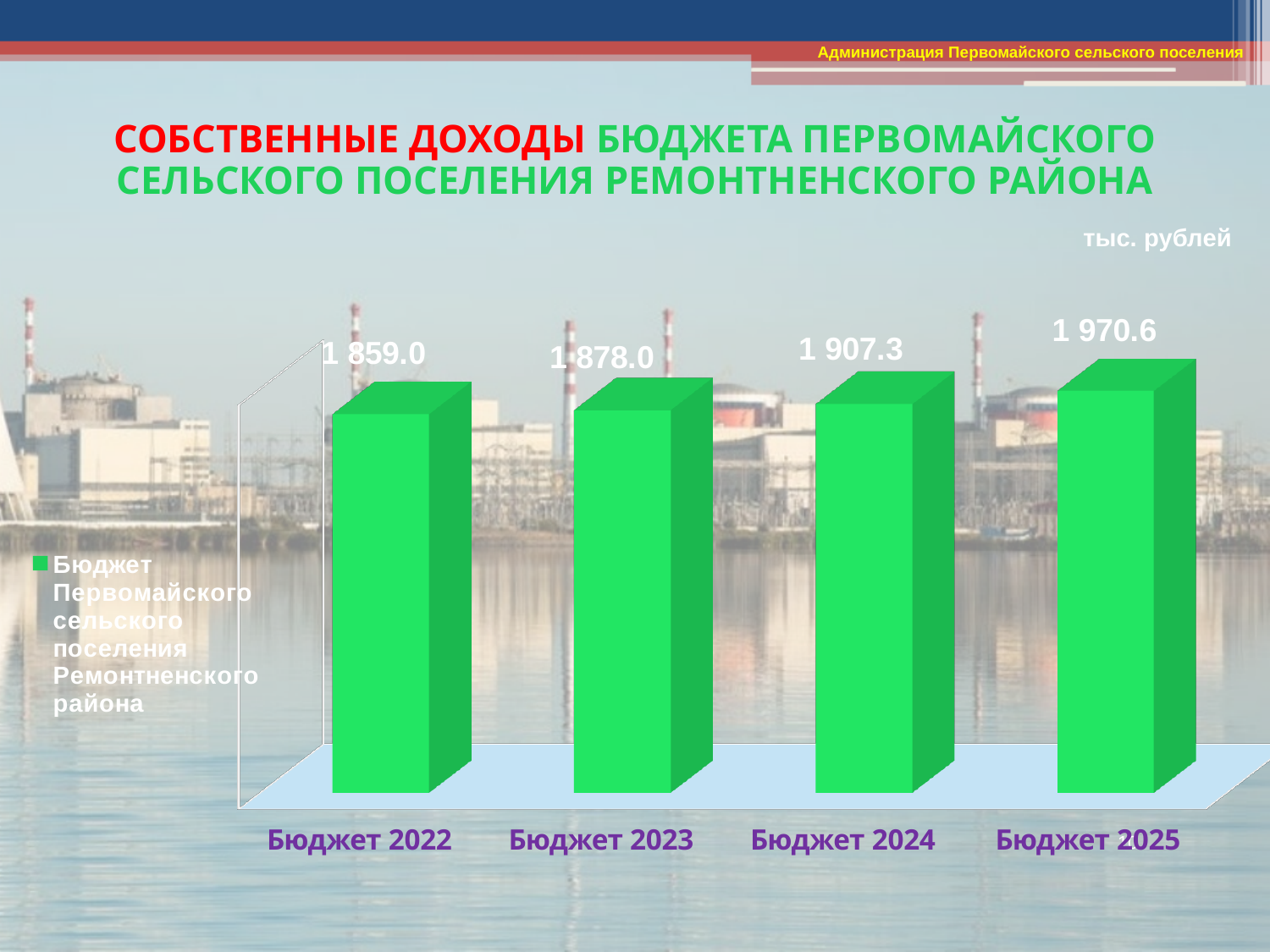
What is the value for Бюджет 2024? 1 907.3 What is the difference between the values for Бюджет 2024 and Бюджет 2023? 29.3 What is the value for Бюджет 2023? 1 878.0 How many categories are shown on the chart? 4 Which category has the highest value? Бюджет 2025 Which category has the lowest value? Бюджет 2022 What kind of chart is shown on the slide? Bar chart Which is larger, the value for Бюджет 2023 or the value for Бюджет 2024? Бюджет 2024 What is the difference between the values for Бюджет 2025 and Бюджет 2022? 111.6 What is the value for Бюджет 2022? 1 859.0 What is the value for Бюджет 2025? 1 970.6 Do the values rise or fall from Бюджет 2022 to Бюджет 2025? Rise